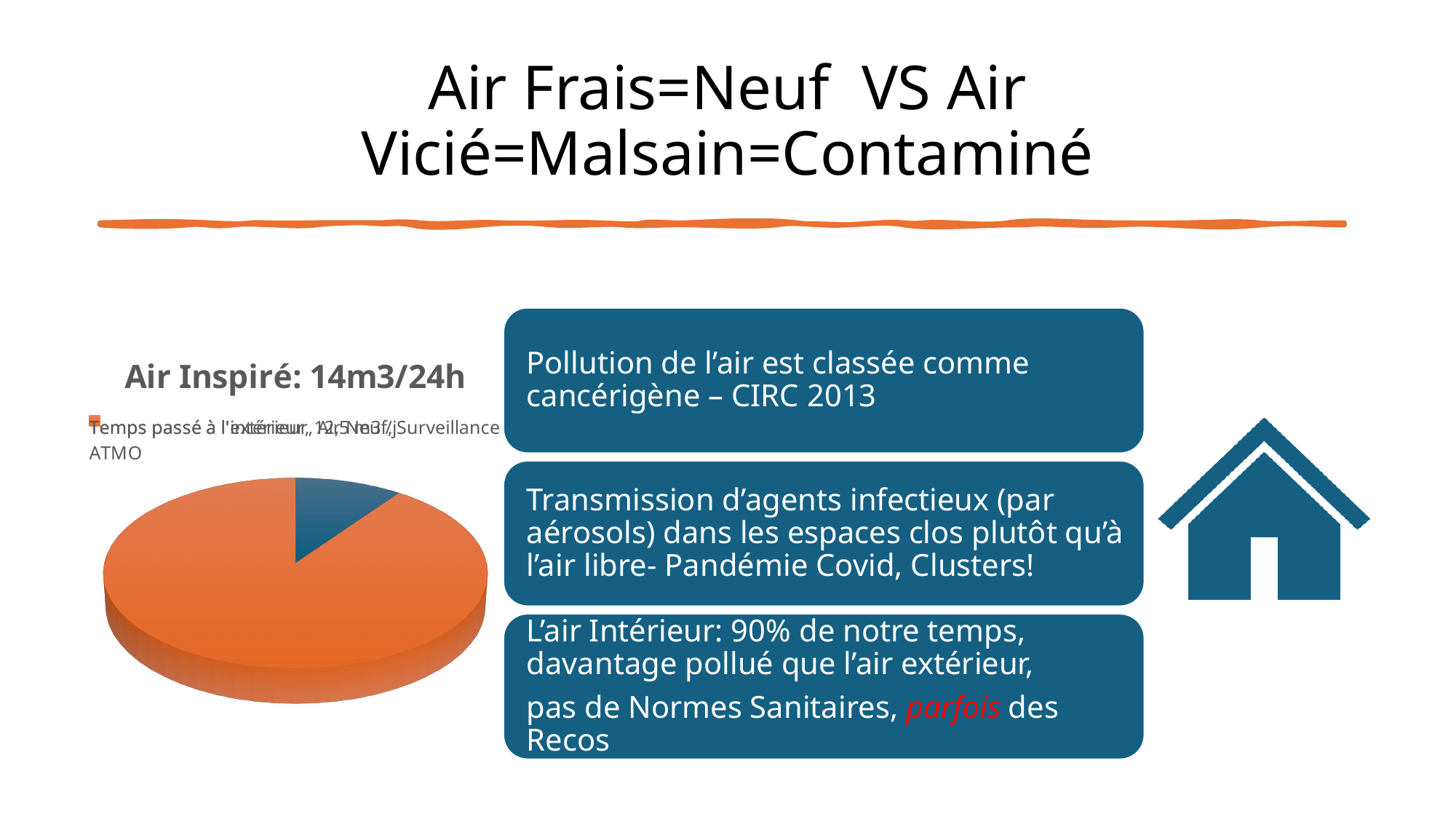
What colour is the smallest slice of the pie chart? blue Which slice of the pie chart is larger, the orange one or the blue one? the orange one What is the title of the pie chart? Air Inspiré: 14m3/24h How many slices does the pie chart have? 2 What colour is the largest slice of the pie chart? orange Is the pie chart drawn in 3D or flat 2D? 3D What kind of chart is shown on the slide? pie chart